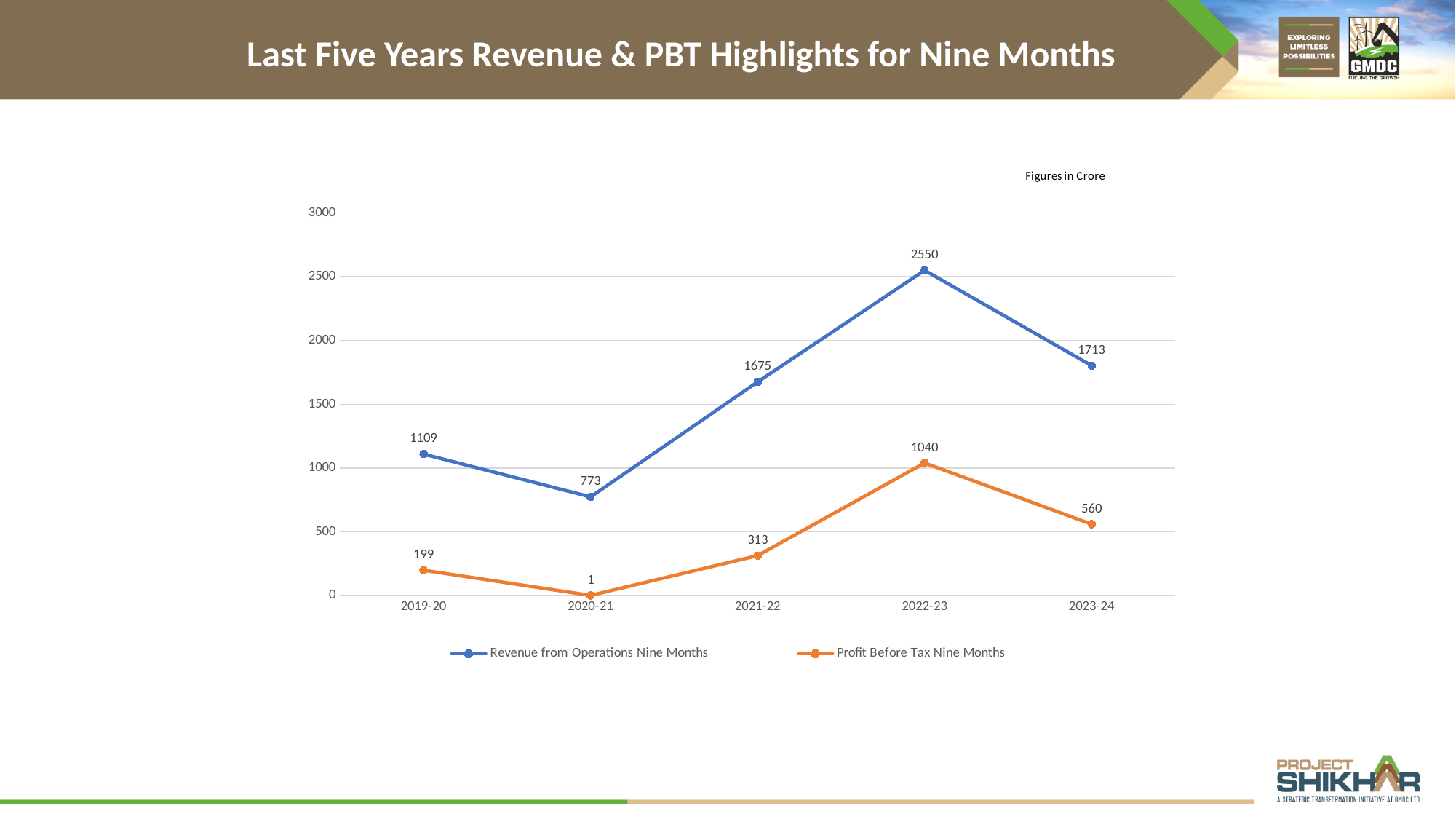
What unit note is printed above the chart? Figures in Crore How many series does the legend list? 2 What is the difference between Revenue from Operations and Profit Before Tax for Nine Months in 2021-22? 1362 What is the difference between Revenue from Operations Nine Months in 2022-23 and 2023-24? 837 What is the Revenue from Operations Nine Months value for 2022-23? 2550 Which is larger: Profit Before Tax Nine Months in 2019-20 or in 2021-22? 2021-22 In which year is Profit Before Tax Nine Months lowest? 2020-21 How many years are shown on the x axis? 5 In which year is Revenue from Operations Nine Months highest? 2022-23 What kind of chart is shown on the slide? Line chart What is the Profit Before Tax Nine Months value for 2023-24? 560 What is the Profit Before Tax Nine Months value for 2020-21? 1